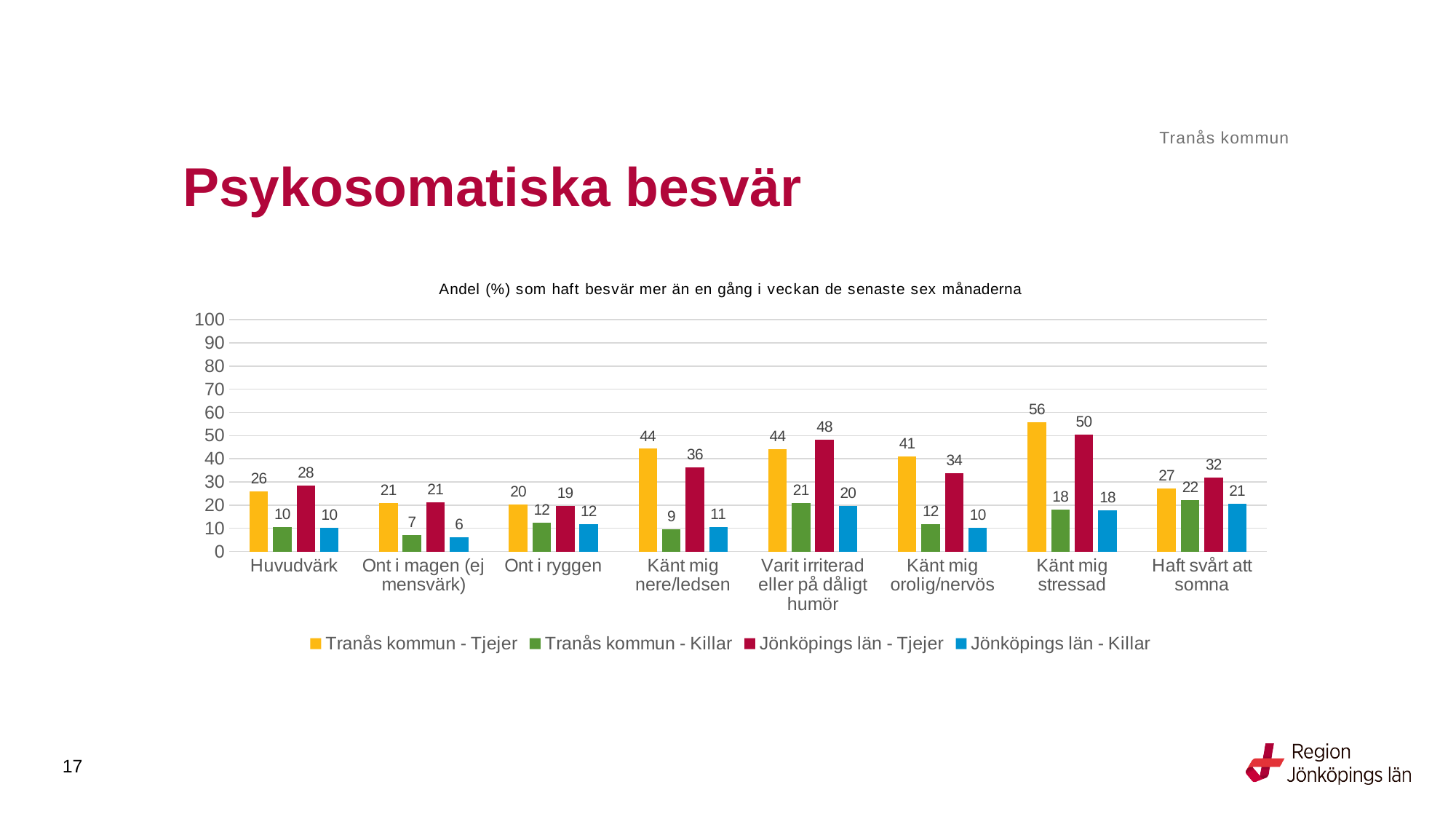
What is the chart's title? Andel (%) som haft besvär mer än en gång i veckan de senaste sex månaderna What is the value for Jönköpings län - Killar in the Ont i magen (ej mensvärk) category? 6 Which colour represents Jönköpings län - Killar in the legend? Blue What kind of chart is shown on the slide? Bar chart What is the value for Tranås kommun - Tjejer in the Känt mig stressad category? 56 Which category has the lowest value for Tranås kommun - Killar? Ont i magen (ej mensvärk) What is the value for Tranås kommun - Killar in the Varit irriterad eller på dåligt humör category? 21 What is the difference between Tranås kommun - Tjejer and Tranås kommun - Killar in the Känt mig stressad category? 38 Which is larger in the Varit irriterad eller på dåligt humör category: Tranås kommun - Tjejer or Jönköpings län - Tjejer? Jönköpings län - Tjejer Which category has the highest value for Jönköpings län - Tjejer? Känt mig stressad How many series does the legend list? 4 How many categories are shown on the x axis? 8